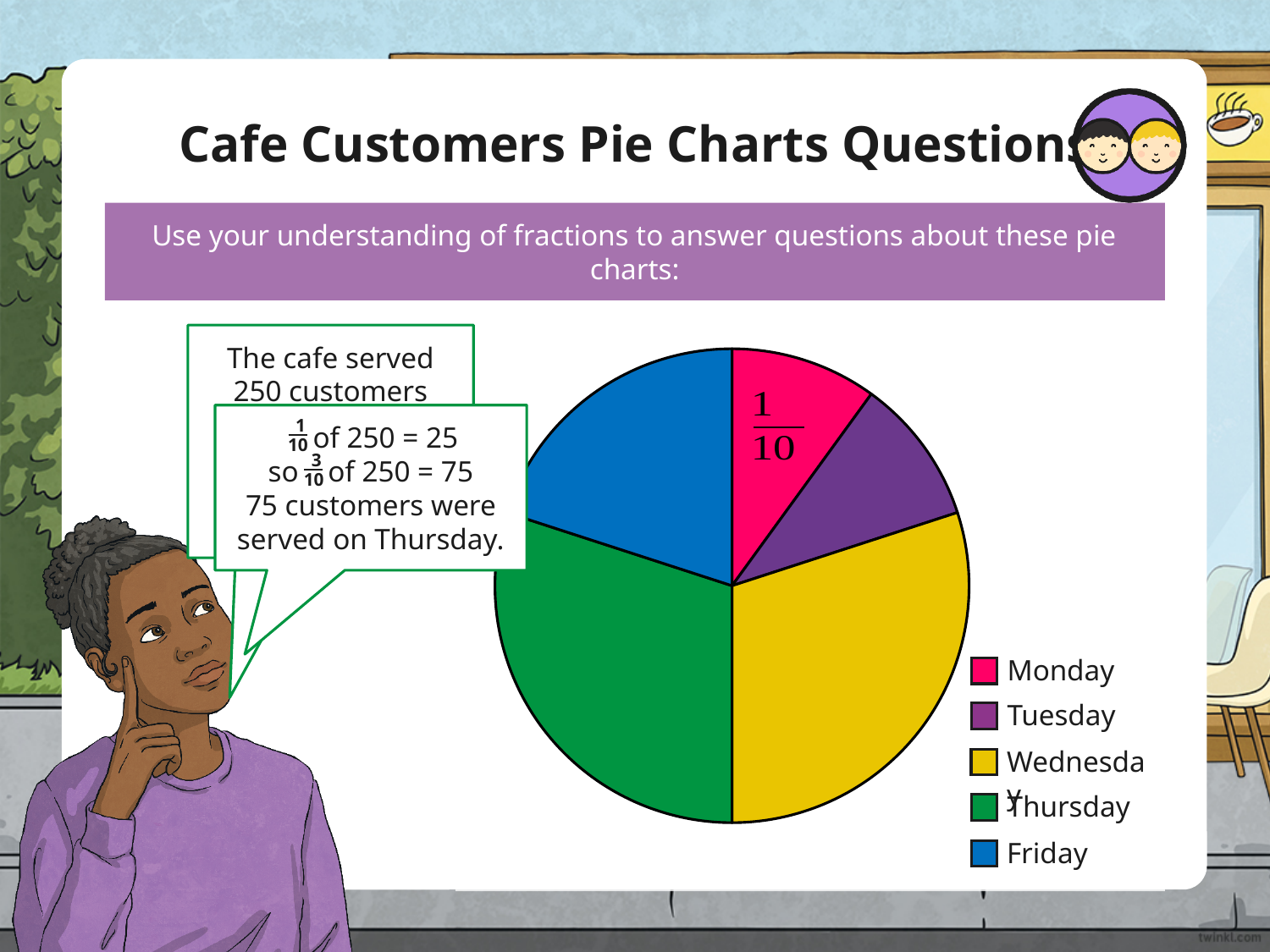
How many entries does the legend list? 5 What fraction of the pie chart is the Thursday slice? 3/10 How many customers did the cafe serve in total? 250 Which day is shown in green in the legend? Thursday How many slices does the pie chart have? 5 What colour is the Friday slice in the pie chart? blue How many customers were served on Thursday? 75 What kind of chart is shown on the slide? pie chart What fraction of the pie chart is the Monday slice? 1/10 Which slice is larger, Thursday or Monday? Thursday Which slice is larger, Wednesday or Monday? Wednesday